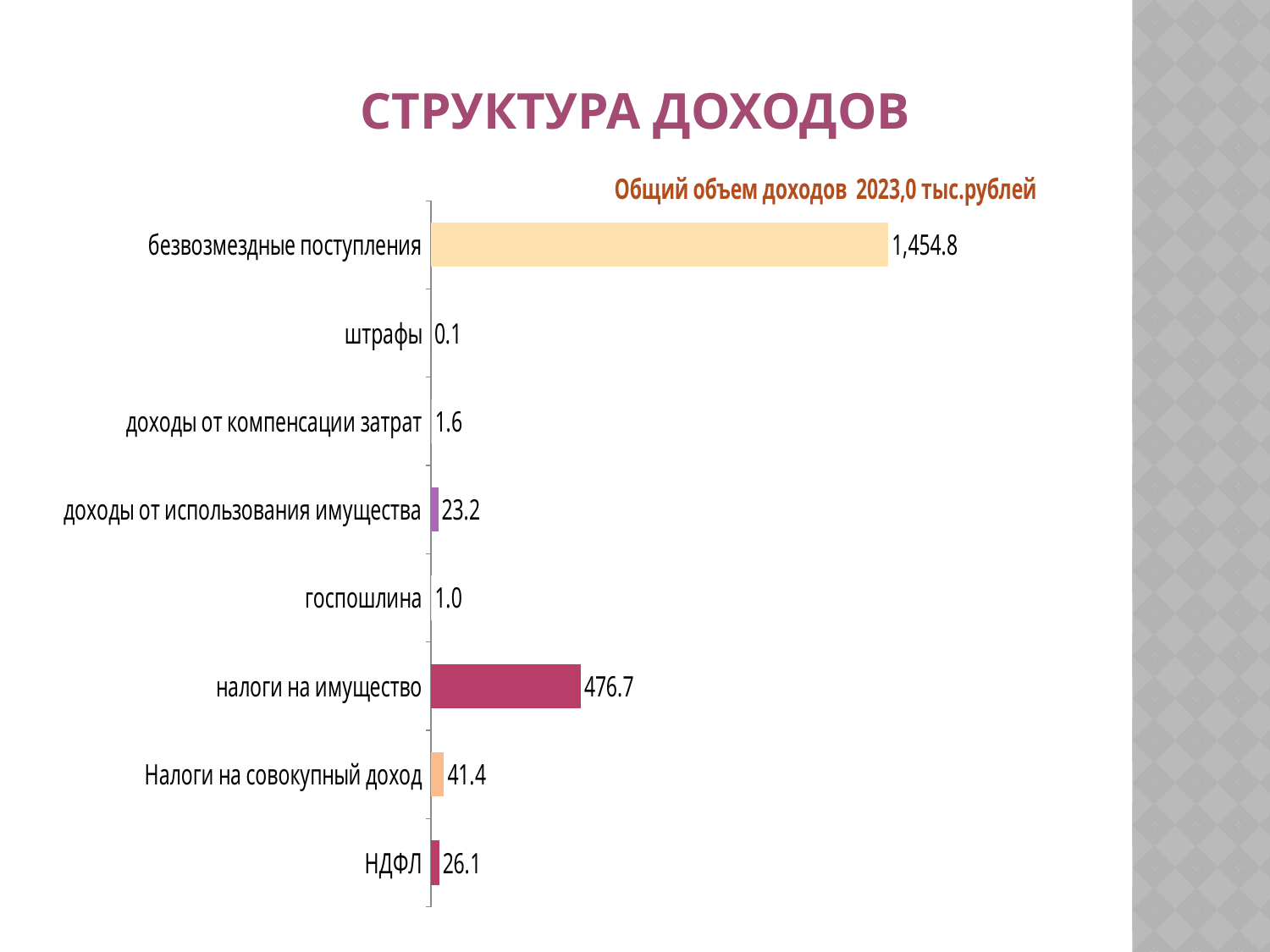
Which category has the lowest value? штрафы What is the value for штрафы? 0.1 Which is larger, доходы от использования имущества or госпошлина? доходы от использования имущества Which category has the highest value? безвозмездные поступления What is the difference between Налоги на совокупный доход and НДФЛ? 15.3 What is the value for НДФЛ? 26.1 What is the value for налоги на имущество? 476.7 What is the value for безвозмездные поступления? 1,454.8 What kind of chart is shown on the slide? bar chart What is the difference between налоги на имущество and Налоги на совокупный доход? 435.3 What is the value for доходы от использования имущества? 23.2 How many categories are shown in the chart? 8